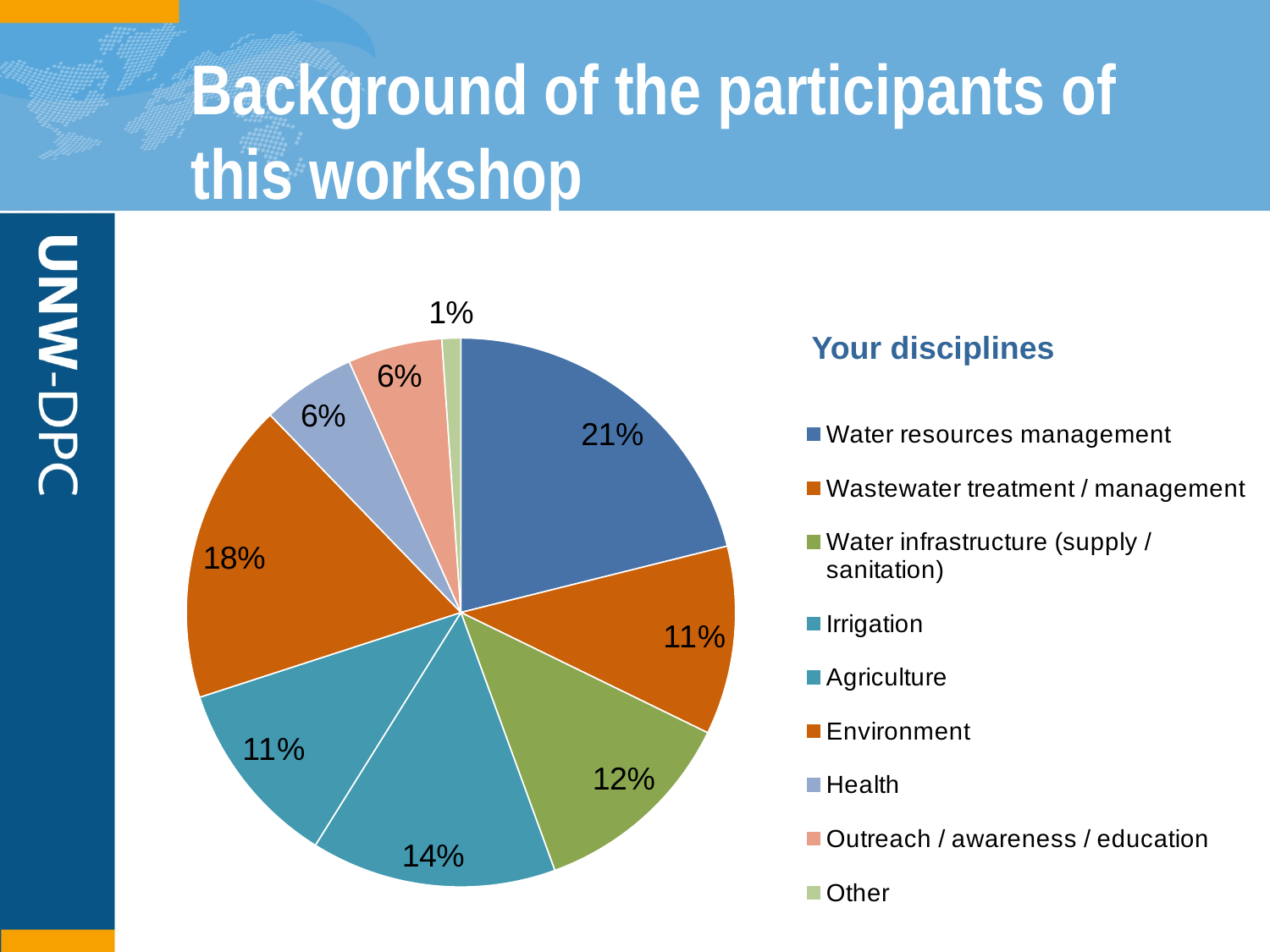
What percentage is shown for Environment? 18% What is the title of the pie chart? Your disciplines How many percentage points larger is the Water resources management slice than the Other slice? 20 percentage points What percentage is shown for Water infrastructure (supply / sanitation)? 12% What share of the pie is labelled Other? 1% How many slices does the pie chart have? 9 What percentage of participants have a background in Water resources management? 21% Which discipline has the largest share of the pie? Water resources management Which is larger, the Water infrastructure (supply / sanitation) slice or the Health slice? Water infrastructure (supply / sanitation) What percentage is shown for Health? 6% What kind of chart is shown on the slide? pie chart Which discipline has the smallest share of the pie? Other